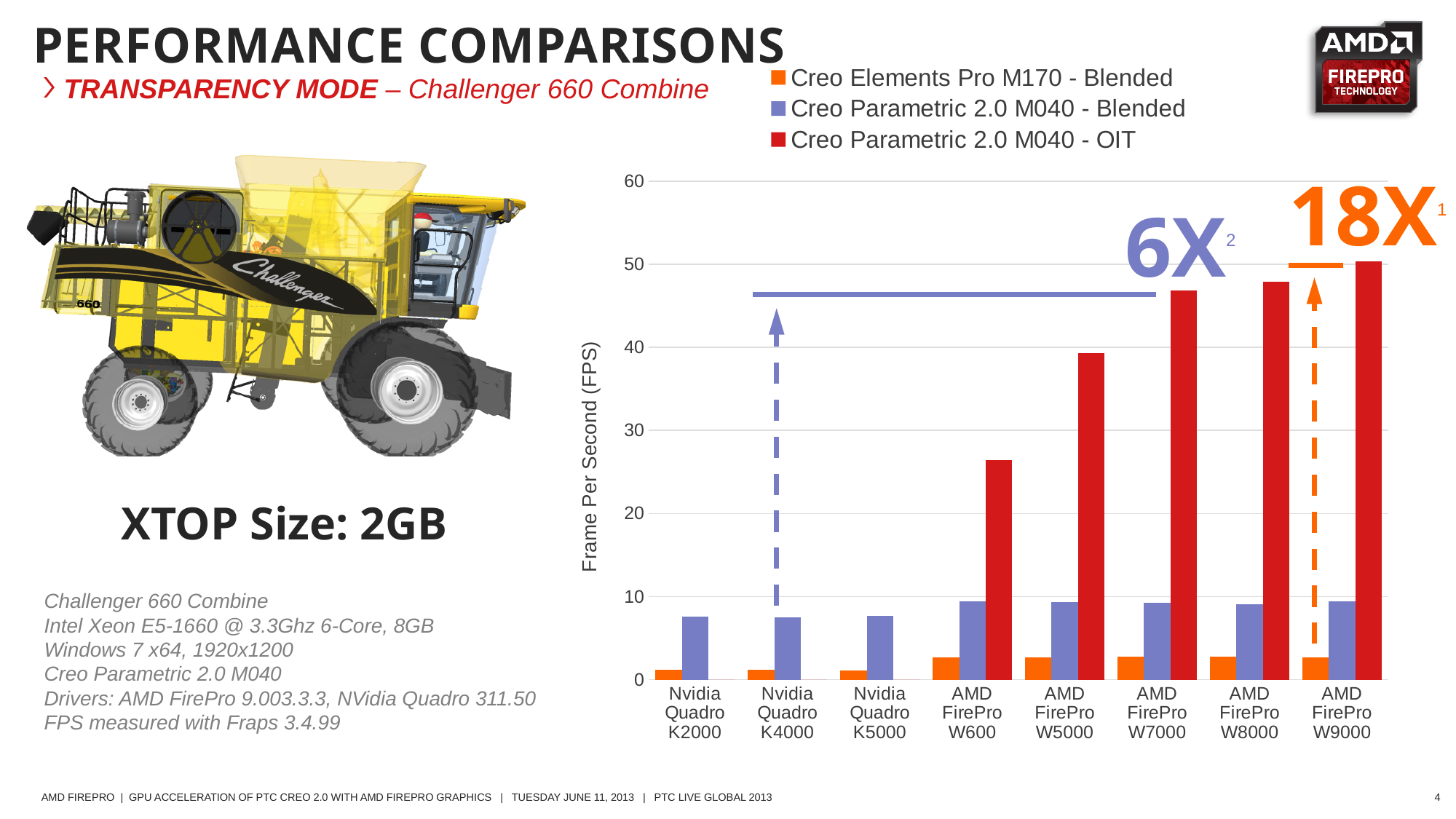
Do the Creo Parametric 2.0 M040 - OIT values rise or fall from AMD FirePro W600 to AMD FirePro W9000 along the x axis? rise What kind of chart is shown on the slide? bar chart Is the Creo Parametric 2.0 M040 - OIT value for AMD FirePro W7000 greater or less than 40? greater How many series does the chart legend list? 3 Is the Creo Elements Pro M170 - Blended value for AMD FirePro W9000 greater or less than 10? less Is the Creo Parametric 2.0 M040 - OIT value for AMD FirePro W600 greater or less than 20? greater Which series is shown in red in the chart? Creo Parametric 2.0 M040 - OIT For AMD FirePro W9000, which is larger: the Creo Parametric 2.0 M040 - Blended value or the Creo Elements Pro M170 - Blended value? Creo Parametric 2.0 M040 - Blended How many graphics cards are listed along the x axis of the chart? 8 What is the label of the vertical axis of the chart? Frame Per Second (FPS) Which has the larger Creo Parametric 2.0 M040 - OIT value, AMD FirePro W600 or AMD FirePro W5000? AMD FirePro W5000